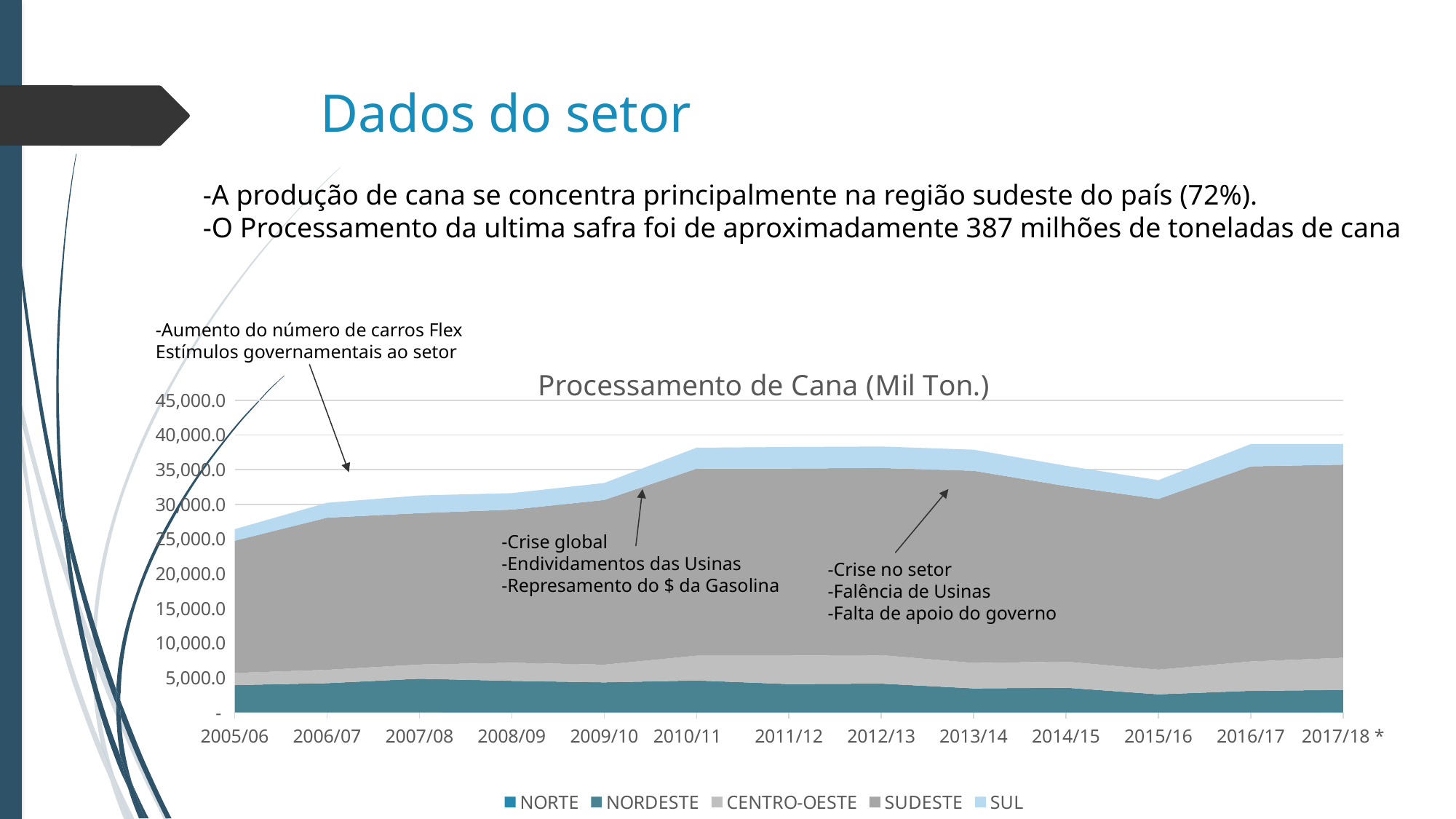
Is the total processing for 2015/16 greater or less than 35,000.0? less Which region contributes the largest share of cane processing in 2017/18 *, SUDESTE or SUL? SUDESTE Is the total processing for 2005/06 greater or less than 30,000.0? less What is the title of the chart? Processamento de Cana (Mil Ton.) Is the total processing for 2017/18 * greater or less than 35,000.0? greater Which series are listed in the chart legend? NORTE, NORDESTE, CENTRO-OESTE, SUDESTE, SUL Does total cane processing rise or fall overall from 2005/06 to 2017/18 *? rise Which season has the lowest total cane processing? 2005/06 How many series does the chart legend list? 5 What kind of chart is shown on the slide? Stacked area chart How many harvest seasons are plotted along the x axis? 13